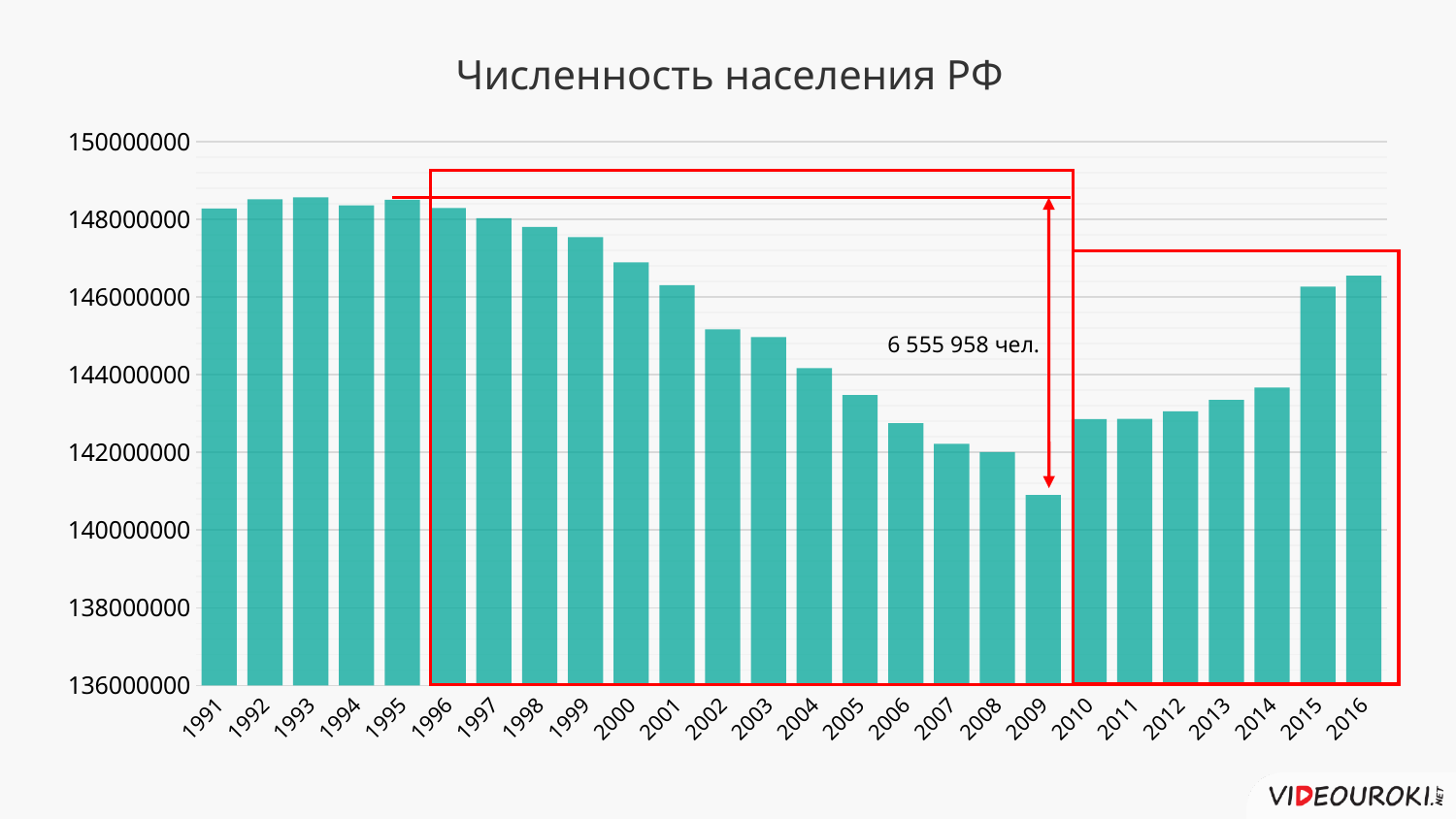
What kind of chart is shown on the slide? bar chart Is the value for 2000 greater or less than 146000000? greater Do the values rise or fall from 1996 to 2009? fall Which year has the lowest population value on the chart? 2009 Is the value for 1993 greater or less than 148000000? greater Is the value for 2009 greater or less than 140000000? greater Which is larger, the value for 1991 or the value for 2016? 1991 How many years (bars) are plotted on the chart? 26 What is the title of the chart? Численность населения РФ What decrease in population is annotated next to the red arrow on the chart? 6 555 958 чел.